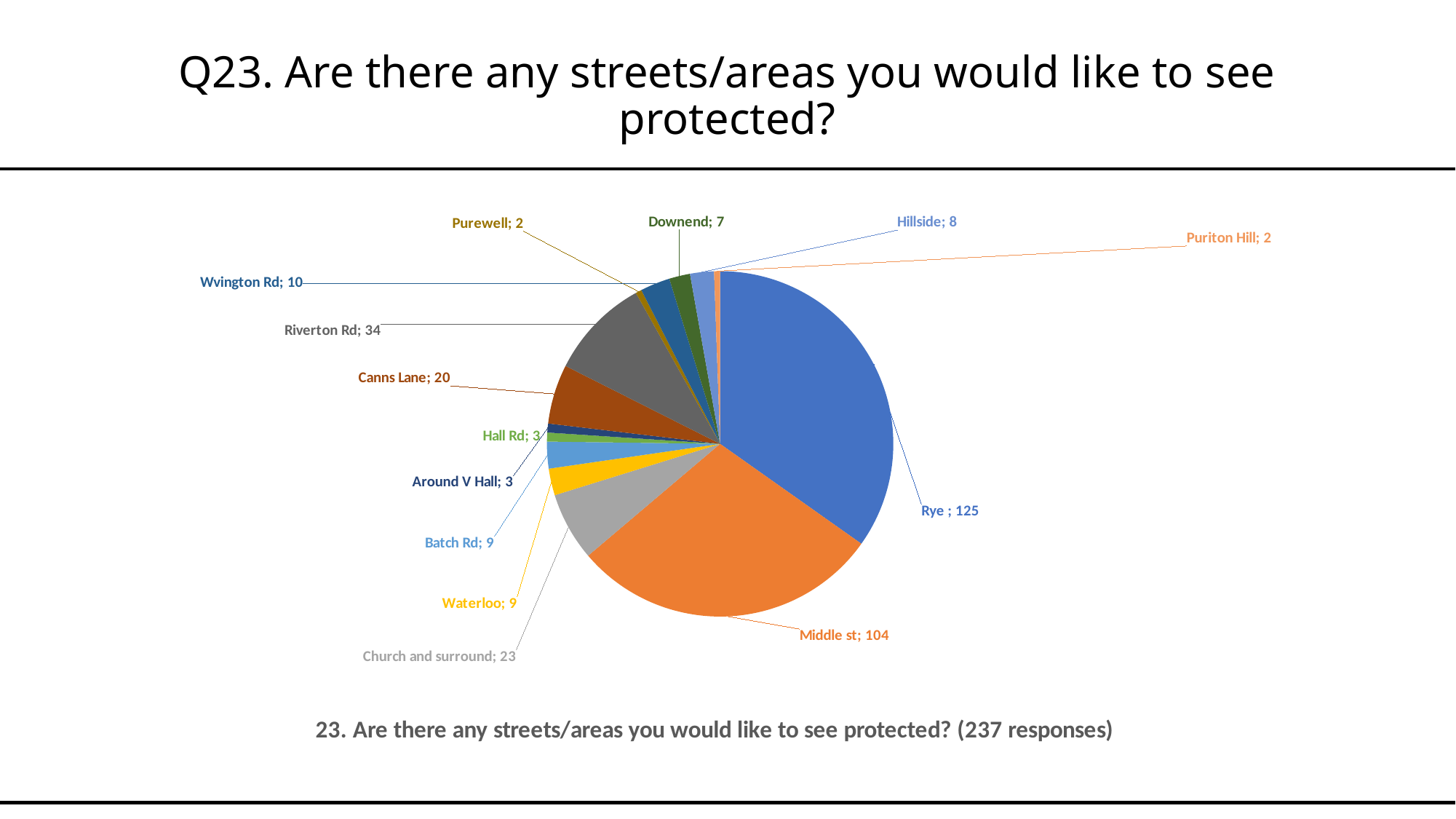
How many streets/areas are shown as slices in the pie chart? 14 Which has a larger value, Downend or Purewell? Downend Which street/area has the largest slice of the pie? Rye What is the value for Riverton Rd? 34 How many responses does the chart caption say Q23 received? 237 responses What is the value for Rye? 125 What is the difference between the values for Wvington Rd and Hillside? 2 What is the value for Middle st? 104 What kind of chart is shown on the slide? Pie chart Which has a larger value, Canns Lane or Riverton Rd? Riverton Rd What is the difference between the values for Rye and Middle st? 21 What is the value for Church and surround? 23